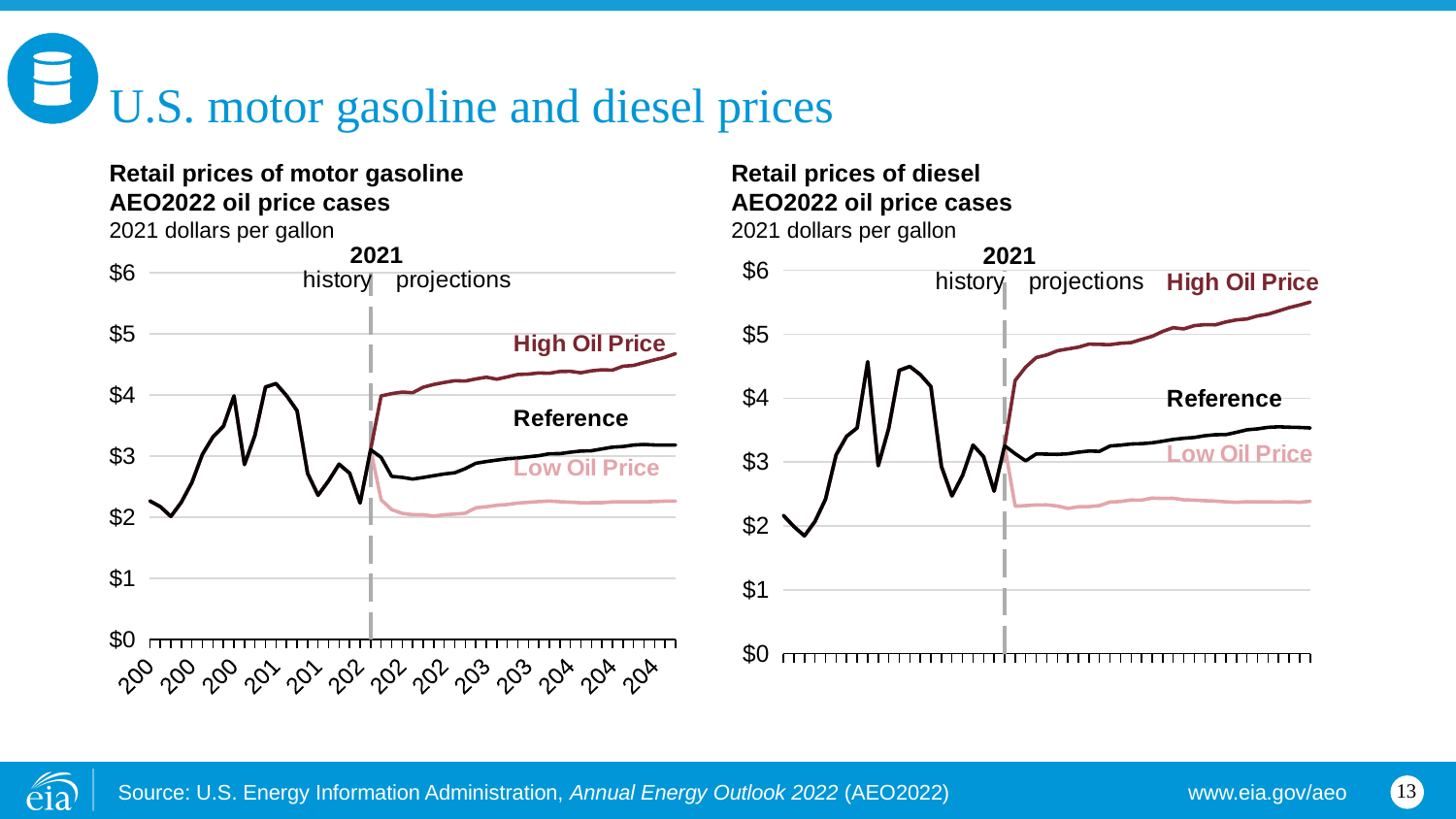
On the 'Retail prices of diesel' chart, is the High Oil Price value at the end of the projection period greater or less than $5? greater On the 'Retail prices of motor gasoline' chart, is the Low Oil Price value at the end of the projection period greater or less than $3? less How many price-case series are plotted on the 'Retail prices of motor gasoline' chart? 3 On the 'Retail prices of diesel' chart, is the Reference value at the end of the projection period greater or less than $4? less On the 'Retail prices of diesel' chart, does the High Oil Price series rise or fall over the projection period? rise What unit is used on the y axis of both charts? 2021 dollars per gallon On the 'Retail prices of motor gasoline' chart, which series is lowest at the end of the projection period? Low Oil Price What kind of chart is the 'Retail prices of diesel' chart? line chart What kind of chart is the 'Retail prices of motor gasoline' chart? line chart On the 'Retail prices of diesel' chart, which series is highest at the end of the projection period? High Oil Price